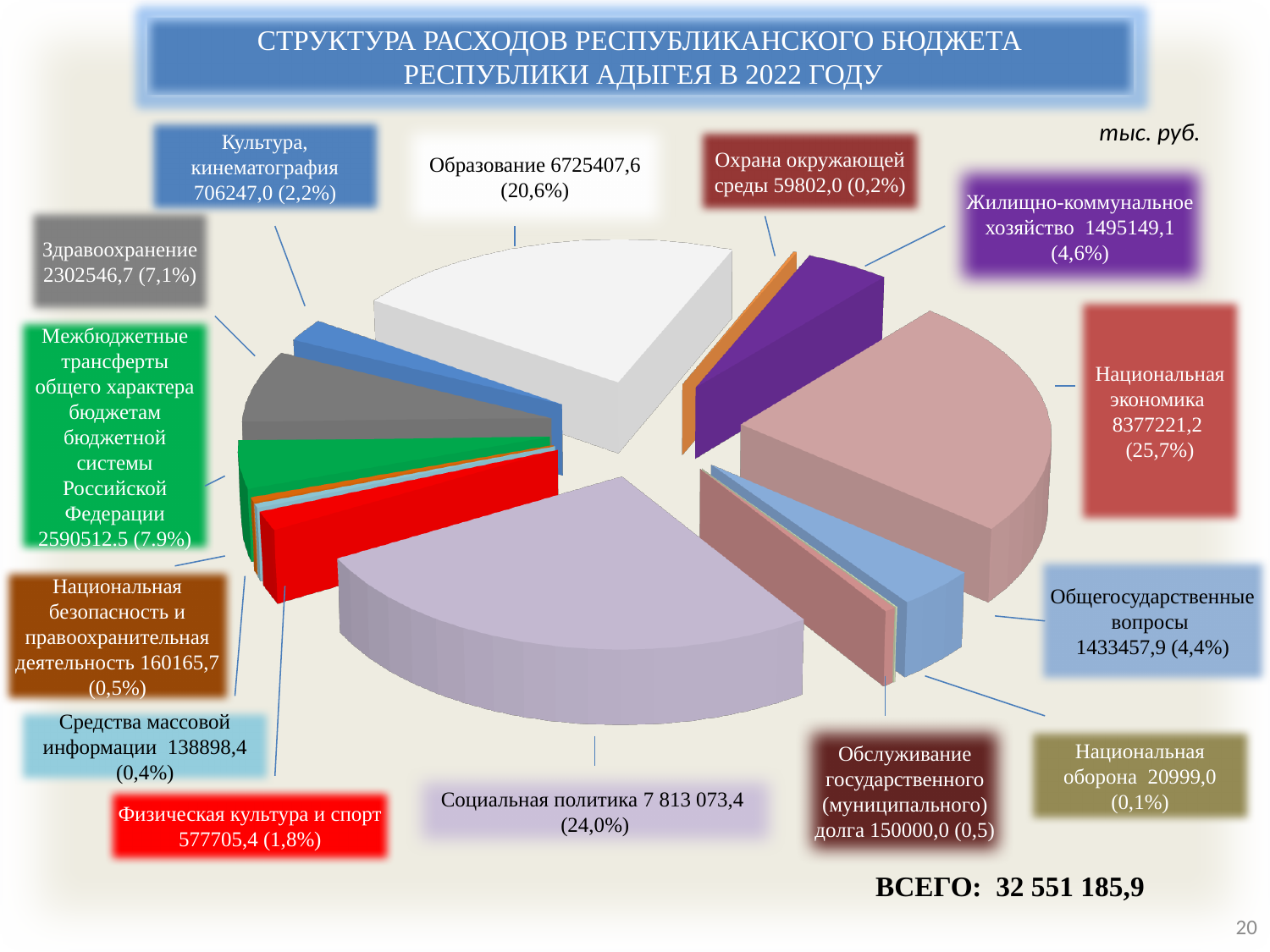
What is the difference between the values for Национальная экономика and Социальная политика? 564147,8 What is the value for Здравоохранение? 2302546,7 What kind of chart is shown on the slide? Pie chart Which is larger, Жилищно-коммунальное хозяйство or Общегосударственные вопросы? Жилищно-коммунальное хозяйство What share of the pie does Социальная политика represent? 24,0% What is the total (ВСЕГО) shown on the slide? 32 551 185,9 In what units are the values on the chart given? тыс. руб. Which category has the smallest share of the pie? Национальная оборона What is the value for Образование? 6725407,6 What share of the pie does Национальная экономика represent? 25,7% Which category has the largest share of the pie? Национальная экономика How many categories are shown in the pie chart? 14